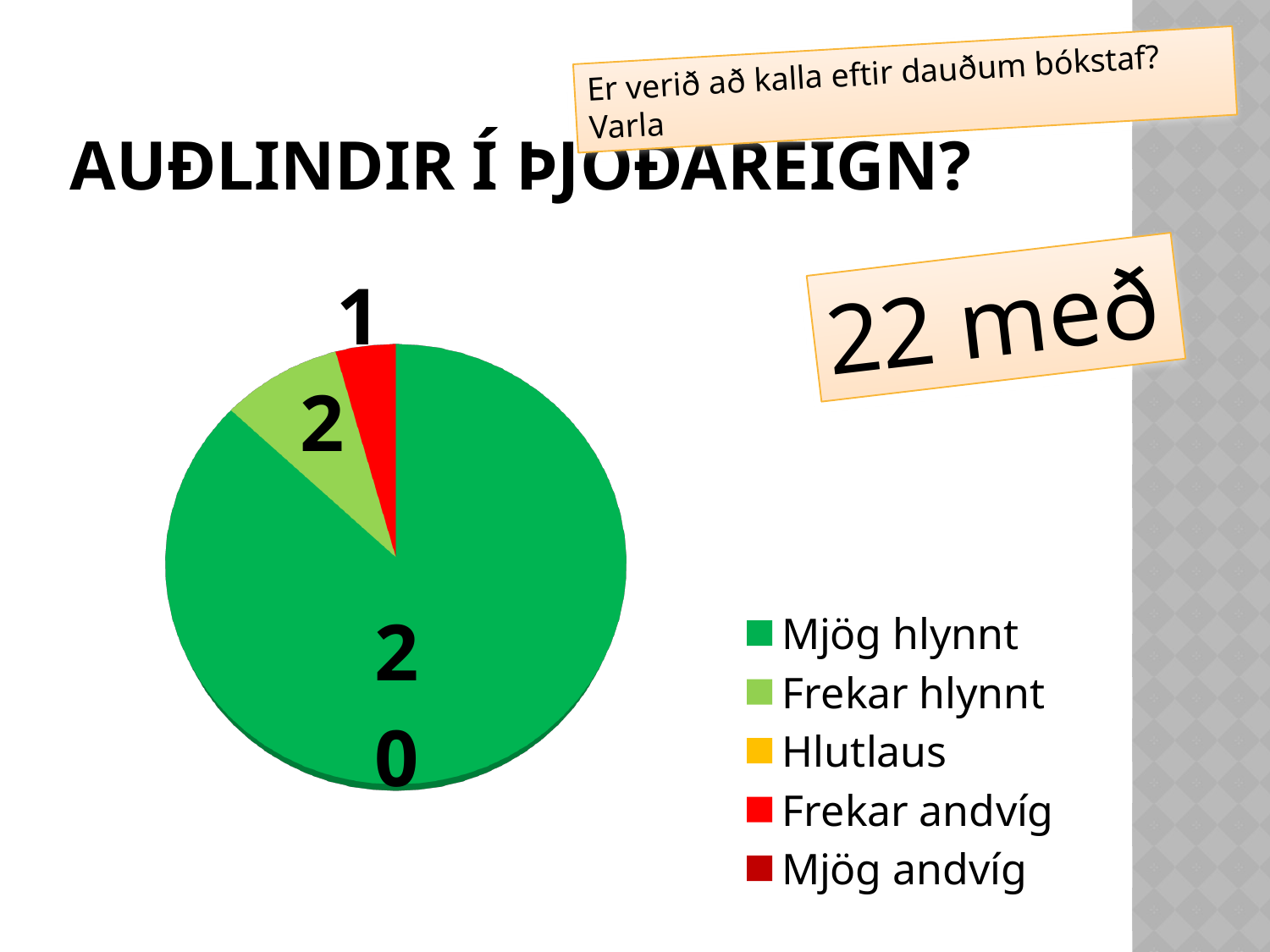
What is the value for Frekar hlynnt in the pie chart? 2 How many entries does the legend of the pie chart list? 5 Which of the slices visible in the pie chart is the smallest? Frekar andvíg Which category has the largest slice of the pie chart? Mjög hlynnt How many slices are visible in the pie chart? 3 What is the total of the three values labelled on the pie chart? 23 What kind of chart is shown on the slide? pie chart Which is larger, the value for Frekar hlynnt or the value for Frekar andvíg? Frekar hlynnt What is the difference between the values for Frekar hlynnt and Frekar andvíg? 1 What is the value for Frekar andvíg in the pie chart? 1 What is the value for Mjög hlynnt in the pie chart? 20 What is the difference between the values for Mjög hlynnt and Frekar hlynnt? 18